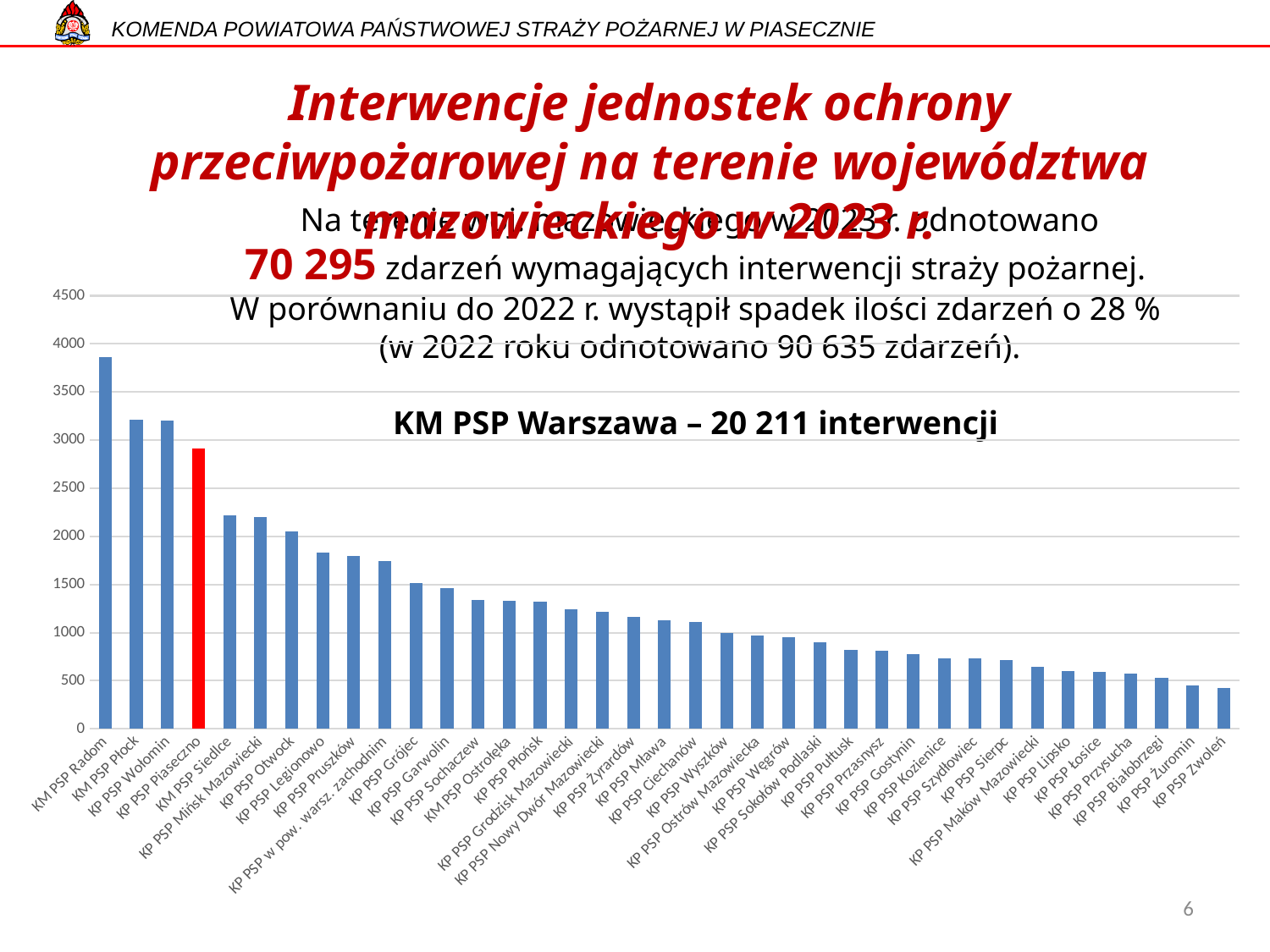
Is the value for KP PSP Legionowo greater or less than 1500? greater Is the value for KM PSP Radom greater or less than 3500? greater Is the value for KP PSP Zwoleń greater or less than 500? less Which category has the highest bar in the chart? KM PSP Radom Which category's bar is coloured red in the chart? KP PSP Piaseczno Which category has the lowest bar in the chart? KP PSP Zwoleń Which is larger, the value for KM PSP Radom or the value for KP PSP Piaseczno? KM PSP Radom What kind of chart is shown on the slide? bar chart Do the bar values rise or fall from left to right along the x axis? fall